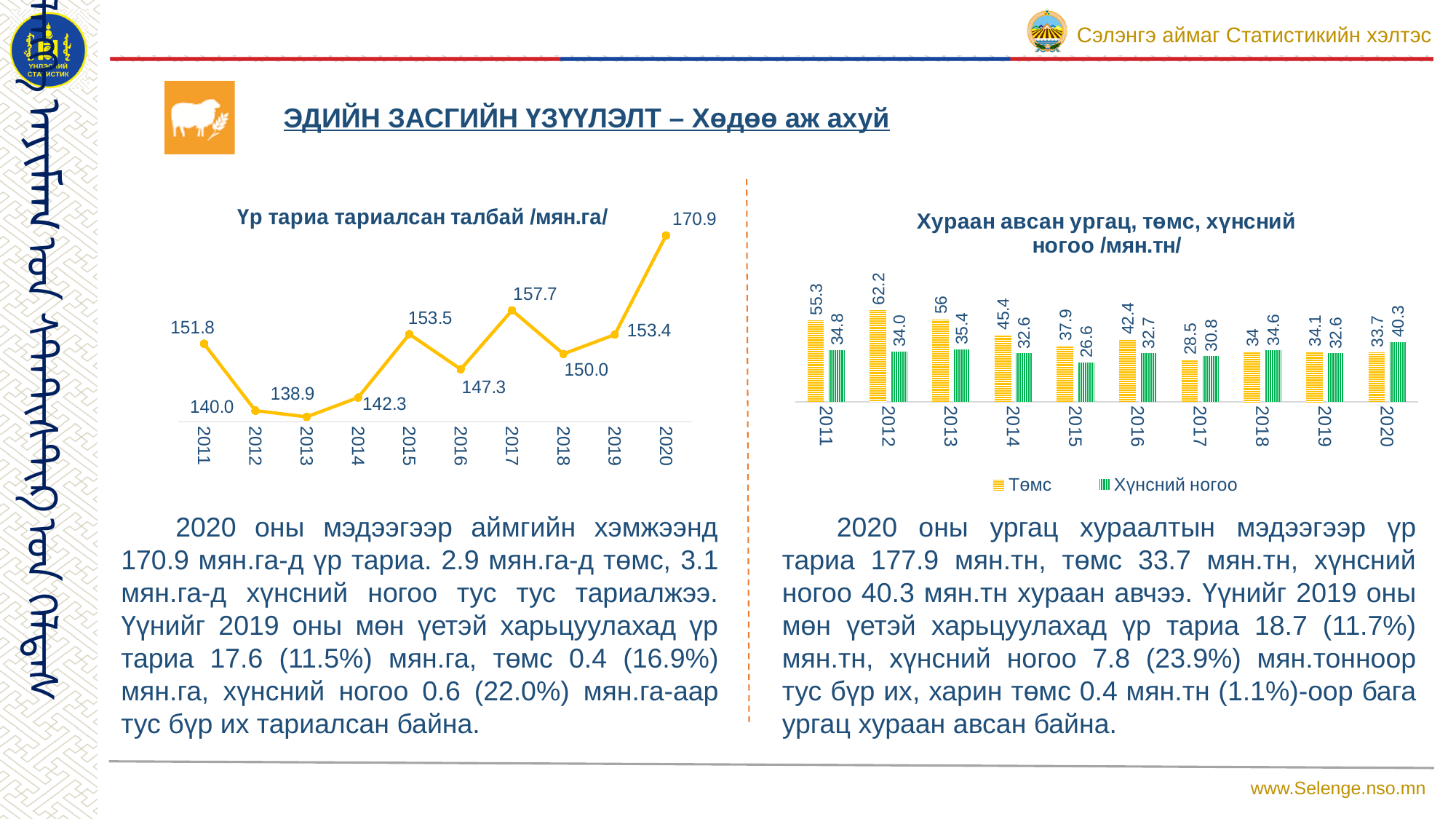
In the chart 'Хураан авсан ургац, төмс, хүнсний ногоо /мян.тн/', what is the Төмс value for 2012? 62.2 What kind of chart is 'Үр тариа тариалсан талбай /мян.га/'? line chart In the chart 'Хураан авсан ургац, төмс, хүнсний ногоо /мян.тн/', which year has the highest Төмс value? 2012 In the chart 'Хураан авсан ургац, төмс, хүнсний ногоо /мян.тн/', how many series does the legend list? 2 In the chart 'Үр тариа тариалсан талбай /мян.га/', is the value for 2017 larger or smaller than the value for 2018? larger In the chart 'Үр тариа тариалсан талбай /мян.га/', what is the value for 2020? 170.9 In the chart 'Үр тариа тариалсан талбай /мян.га/', what is the difference between the 2020 and 2019 values? 17.5 In the chart 'Үр тариа тариалсан талбай /мян.га/', which year has the lowest value? 2013 In the chart 'Хураан авсан ургац, төмс, хүнсний ногоо /мян.тн/', what is the Хүнсний ногоо value for 2020? 40.3 In the chart 'Үр тариа тариалсан талбай /мян.га/', how many years are plotted? 10 In the chart 'Хураан авсан ургац, төмс, хүнсний ногоо /мян.тн/', which year has the lowest Хүнсний ногоо value? 2015 In the chart 'Хураан авсан ургац, төмс, хүнсний ногоо /мян.тн/', what is the difference between the Төмс and Хүнсний ногоо values for 2011? 20.5